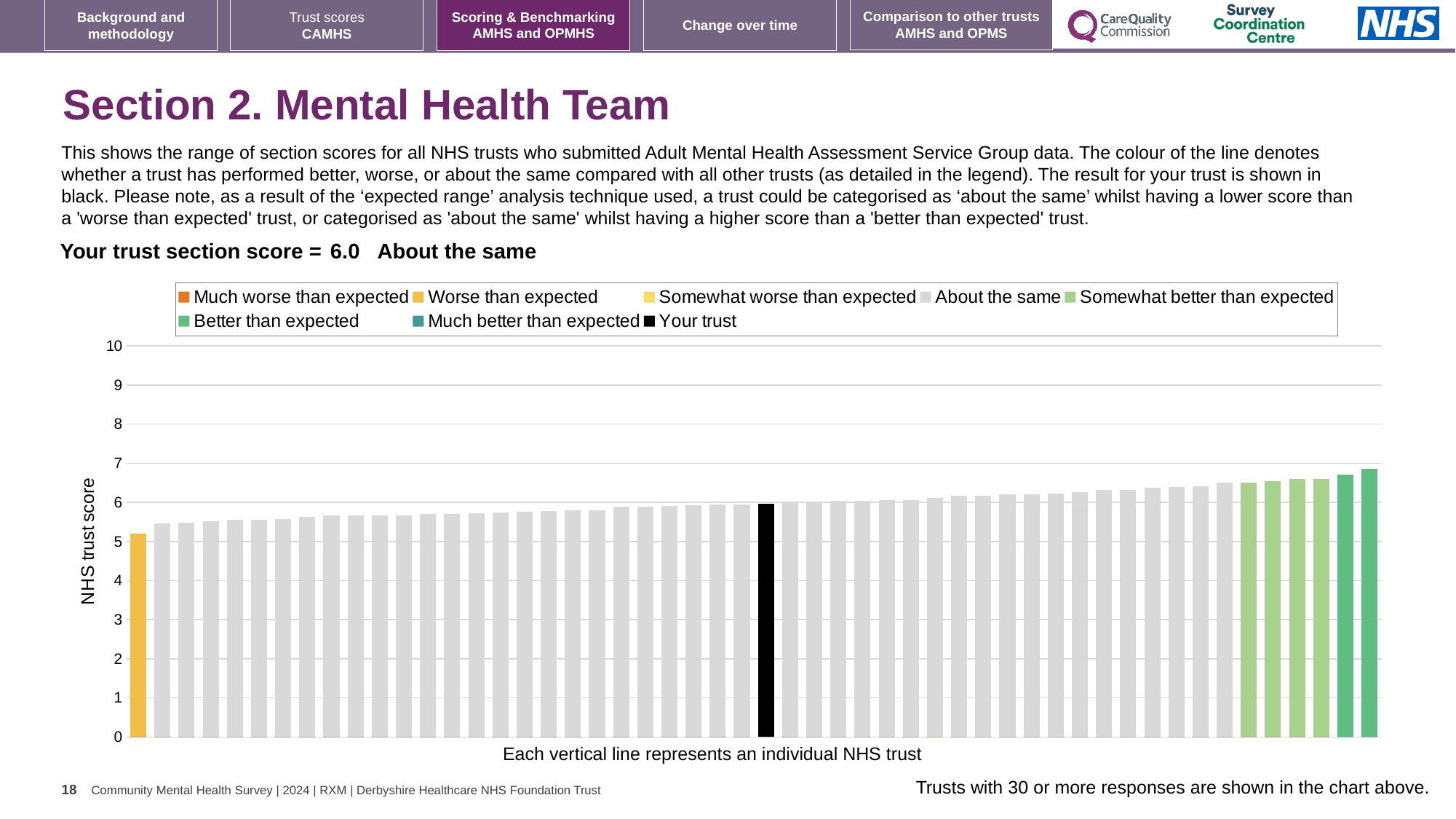
How many bars are coloured as 'Worse than expected' (yellow)? 1 How many entries does the chart legend list? 8 What is the label on the vertical axis of the chart? NHS trust score What does the text below the x axis say each vertical line represents? An individual NHS trust What is the section score for your trust shown on the slide? 6.0 Is the value of the shortest bar in the chart greater or less than 6? less Do the bar values rise or fall moving from left to right along the x axis? rise What kind of chart is shown on the slide? Bar chart Which performance category is your trust placed in for this section? About the same Is the value of the tallest bar in the chart greater or less than 7? less How many bars are coloured as 'Somewhat better than expected' (light green)? 4 Is the value of the black bar (your trust) greater or less than 5? greater